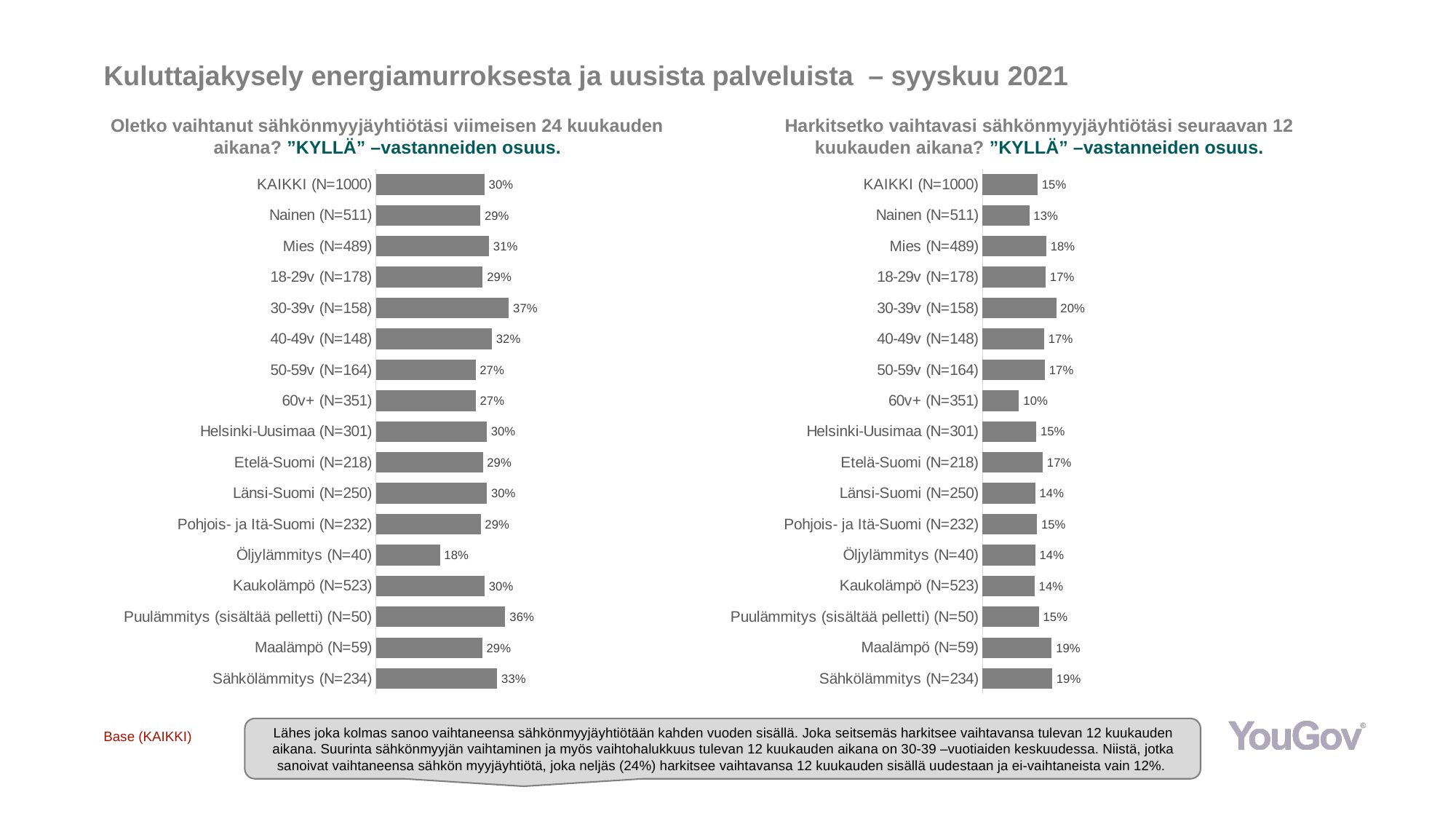
In the right chart (Harkitsetko vaihtavasi sähkönmyyjäyhtiötäsi seuraavan 12 kuukauden aikana?), which category has the lowest value? 60v+ (N=351) In the left chart (Oletko vaihtanut sähkönmyyjäyhtiötäsi viimeisen 24 kuukauden aikana?), what is the difference between the values for 30-39v (N=158) and Öljylämmitys (N=40)? 19 percentage points In the left chart (Oletko vaihtanut sähkönmyyjäyhtiötäsi viimeisen 24 kuukauden aikana?), which category has the highest value? 30-39v (N=158) What kind of chart is the right chart (Harkitsetko vaihtavasi sähkönmyyjäyhtiötäsi seuraavan 12 kuukauden aikana?)? Bar chart In the right chart (Harkitsetko vaihtavasi sähkönmyyjäyhtiötäsi seuraavan 12 kuukauden aikana?), which is larger: the value for Nainen (N=511) or Mies (N=489)? Mies (N=489) In the left chart (Oletko vaihtanut sähkönmyyjäyhtiötäsi viimeisen 24 kuukauden aikana?), what is the value for Sähkölämmitys (N=234)? 33% In the right chart (Harkitsetko vaihtavasi sähkönmyyjäyhtiötäsi seuraavan 12 kuukauden aikana?), which category has the highest value? 30-39v (N=158) In the left chart (Oletko vaihtanut sähkönmyyjäyhtiötäsi viimeisen 24 kuukauden aikana?), which category has the lowest value? Öljylämmitys (N=40) In the right chart (Harkitsetko vaihtavasi sähkönmyyjäyhtiötäsi seuraavan 12 kuukauden aikana?), what is the difference between the values for 30-39v (N=158) and 60v+ (N=351)? 10 percentage points In the left chart (Oletko vaihtanut sähkönmyyjäyhtiötäsi viimeisen 24 kuukauden aikana?), how many categories are shown? 17 In the right chart (Harkitsetko vaihtavasi sähkönmyyjäyhtiötäsi seuraavan 12 kuukauden aikana?), what is the value for Mies (N=489)? 18% In the left chart (Oletko vaihtanut sähkönmyyjäyhtiötäsi viimeisen 24 kuukauden aikana?), what is the value for KAIKKI (N=1000)? 30%